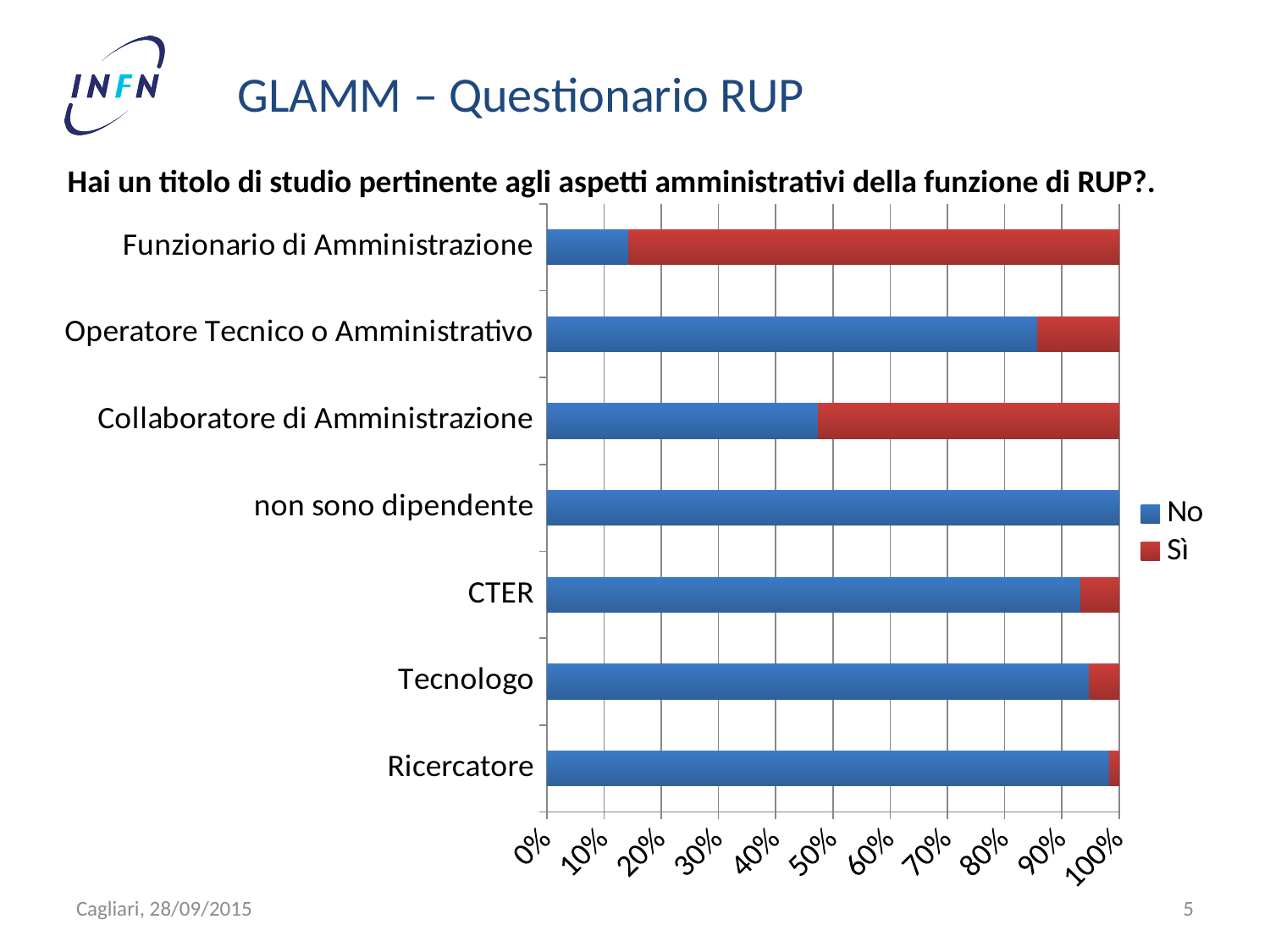
How many categories are shown on the vertical axis of the chart? 7 What kind of chart is shown on the slide? Stacked bar chart Is the 'No' value for 'Collaboratore di Amministrazione' greater or less than 50%? less Which category has the largest 'Sì' share? Funzionario di Amministrazione How many series does the legend list? 2 Is the 'No' value for 'Funzionario di Amministrazione' greater or less than 20%? less Which category has the smallest 'No' share? Funzionario di Amministrazione Which colour represents the 'No' series in the chart? Blue Is the 'No' value for 'Operatore Tecnico o Amministrativo' greater or less than 80%? greater What is the 'No' value for 'non sono dipendente'? 100% Which has the larger 'No' share: 'Collaboratore di Amministrazione' or 'Operatore Tecnico o Amministrativo'? Operatore Tecnico o Amministrativo Which has the larger 'Sì' share: 'CTER' or 'Collaboratore di Amministrazione'? Collaboratore di Amministrazione